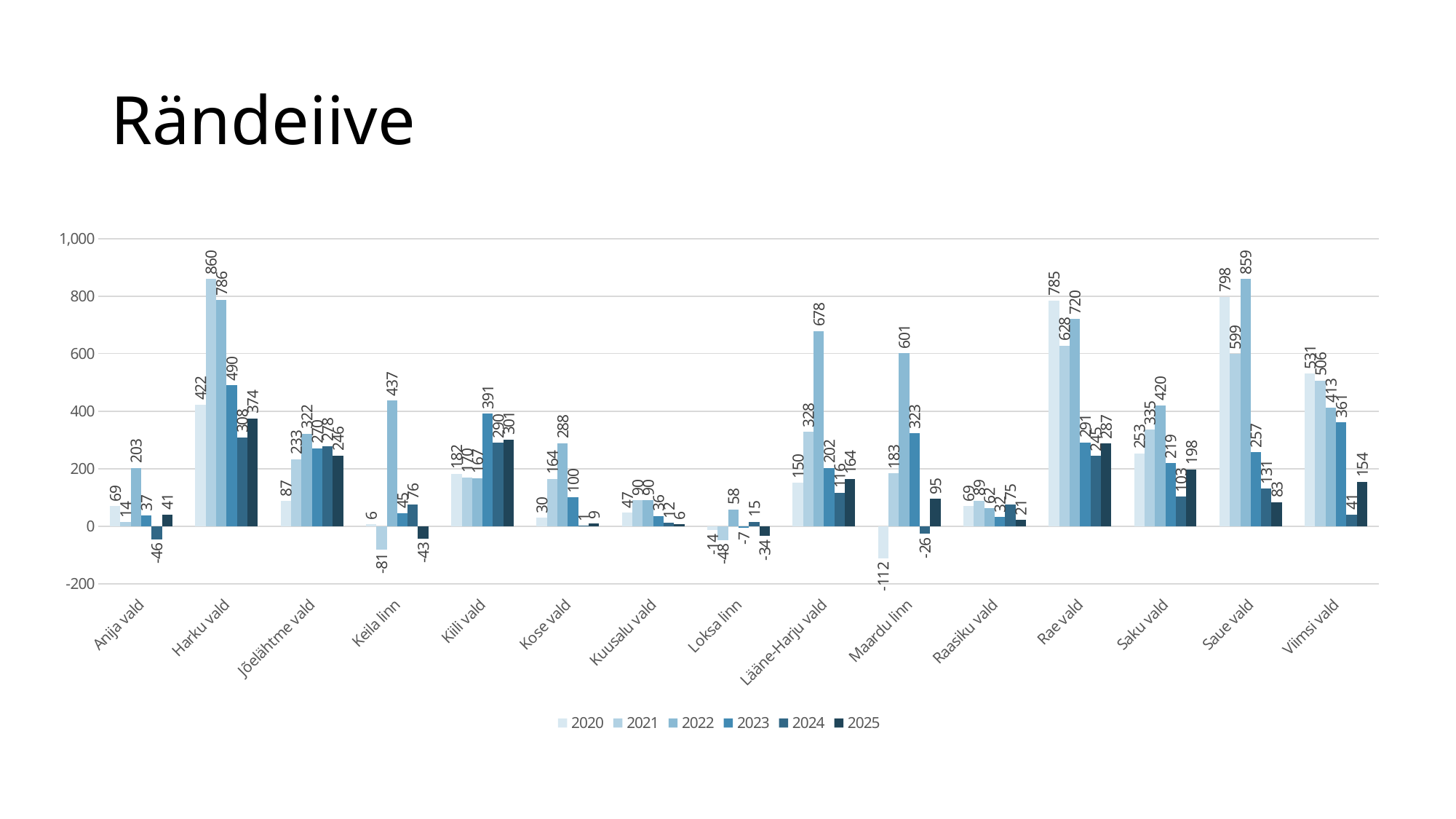
Which category has the highest value in the 2021 series? Harku vald What is the difference between the 2022 and 2023 values for Saue vald? 602 Which category has the lowest value in the 2020 series? Maardu linn What kind of chart is shown on the slide? bar chart What is the value for Keila linn in 2022? 437 What is the value for Maardu linn in 2020? -112 How many categories are shown on the x axis? 15 What is the value for Harku vald in 2021? 860 What is the value for Lääne-Harju vald in 2022? 678 How many series does the legend list? 6 Is the 2022 value for Harku vald greater or less than 600? greater Which is larger, the 2020 value for Rae vald or the 2020 value for Saue vald? Saue vald